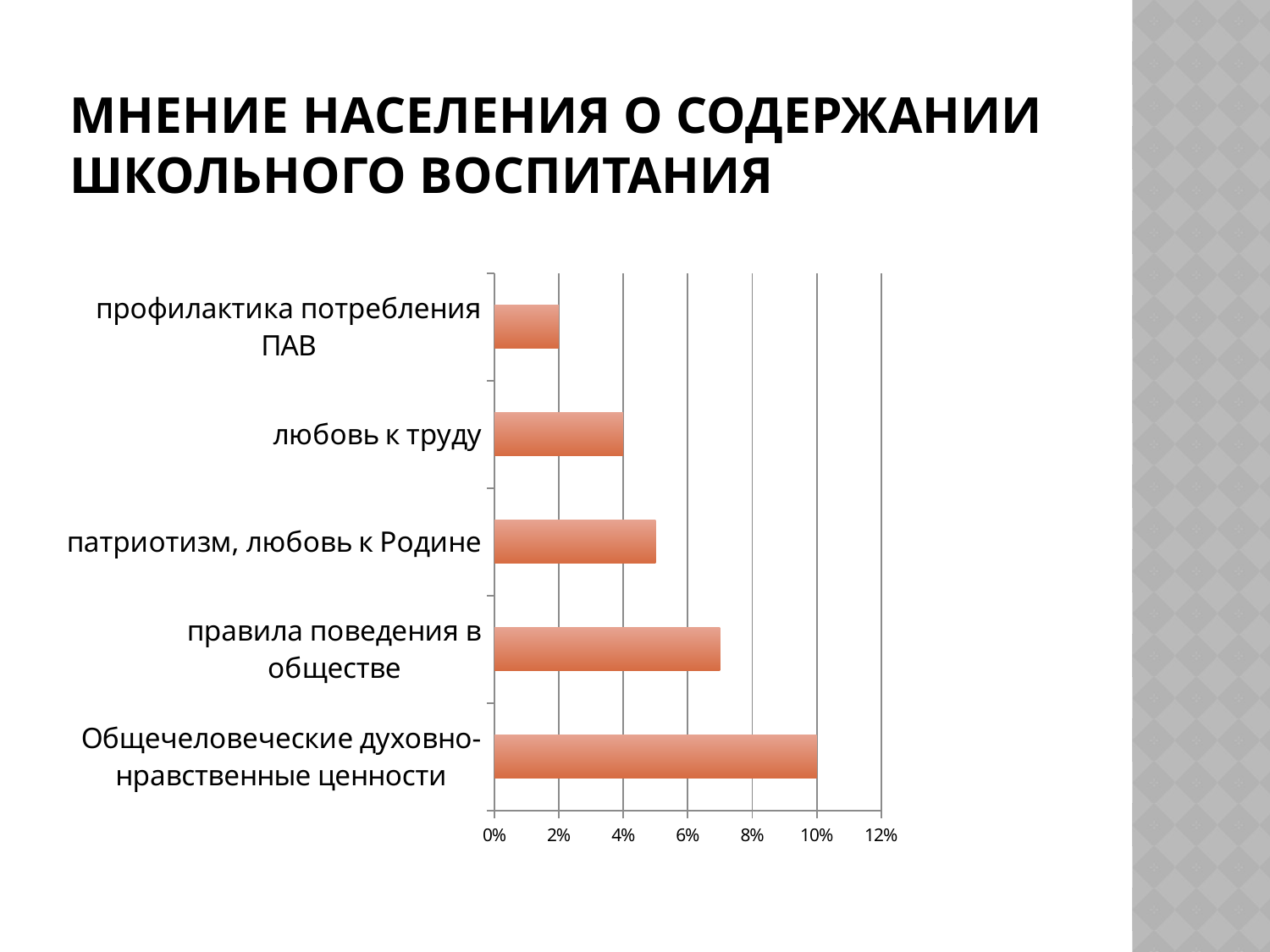
How many categories does the chart show? 5 What is the value for Общечеловеческие духовно-нравственные ценности? 10% What is the difference between the values for Общечеловеческие духовно-нравственные ценности and профилактика потребления ПАВ? 8% What is the value for любовь к труду? 4% Which category has the lowest value? профилактика потребления ПАВ What kind of chart is shown on the slide? bar chart Is the value for правила поведения в обществе greater or less than 8%? less What is the highest value shown on the horizontal axis? 12% Which category has the highest value? Общечеловеческие духовно-нравственные ценности What is the value for профилактика потребления ПАВ? 2% Is the value for патриотизм, любовь к Родине greater or less than 4%? greater Which is larger: the value for правила поведения в обществе or the value for любовь к труду? правила поведения в обществе